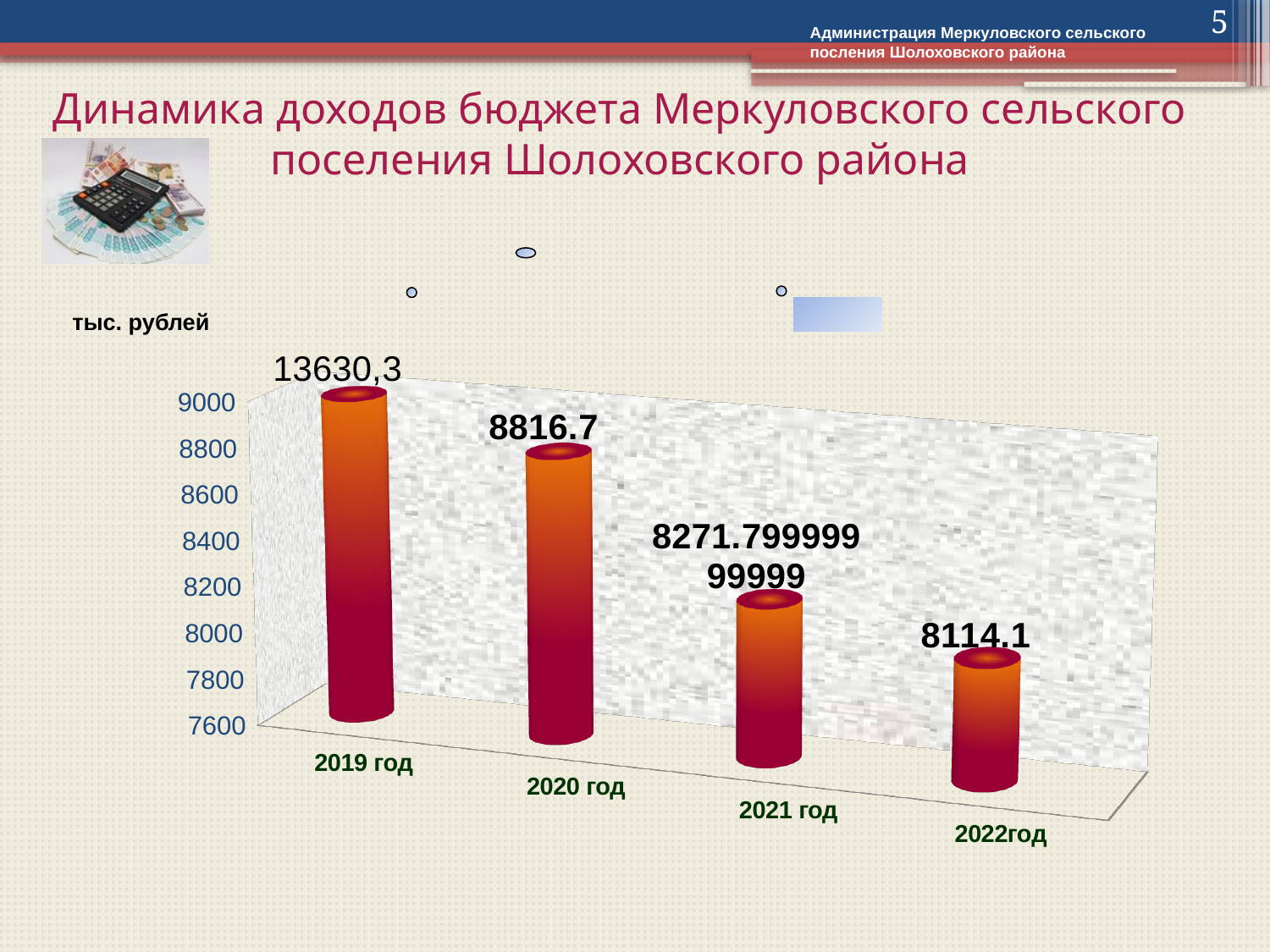
How many years are shown on the chart? 4 What is the value for 2022год? 8114.1 Which year has the lowest value? 2022год Is the value for 2021 год greater or less than 8200? greater What is the value for 2020 год? 8816.7 Which year has the highest value? 2019 год Is the value for 2022год greater or less than 8200? less Which is larger, the value for 2020 год or the value for 2021 год? 2020 год What is the difference between the values for 2020 год and 2022год? 702.6 What kind of chart is shown on the slide? bar chart What is the value shown for 2019 год? 13630,3 Do the values rise or fall from 2019 год to 2022год? fall